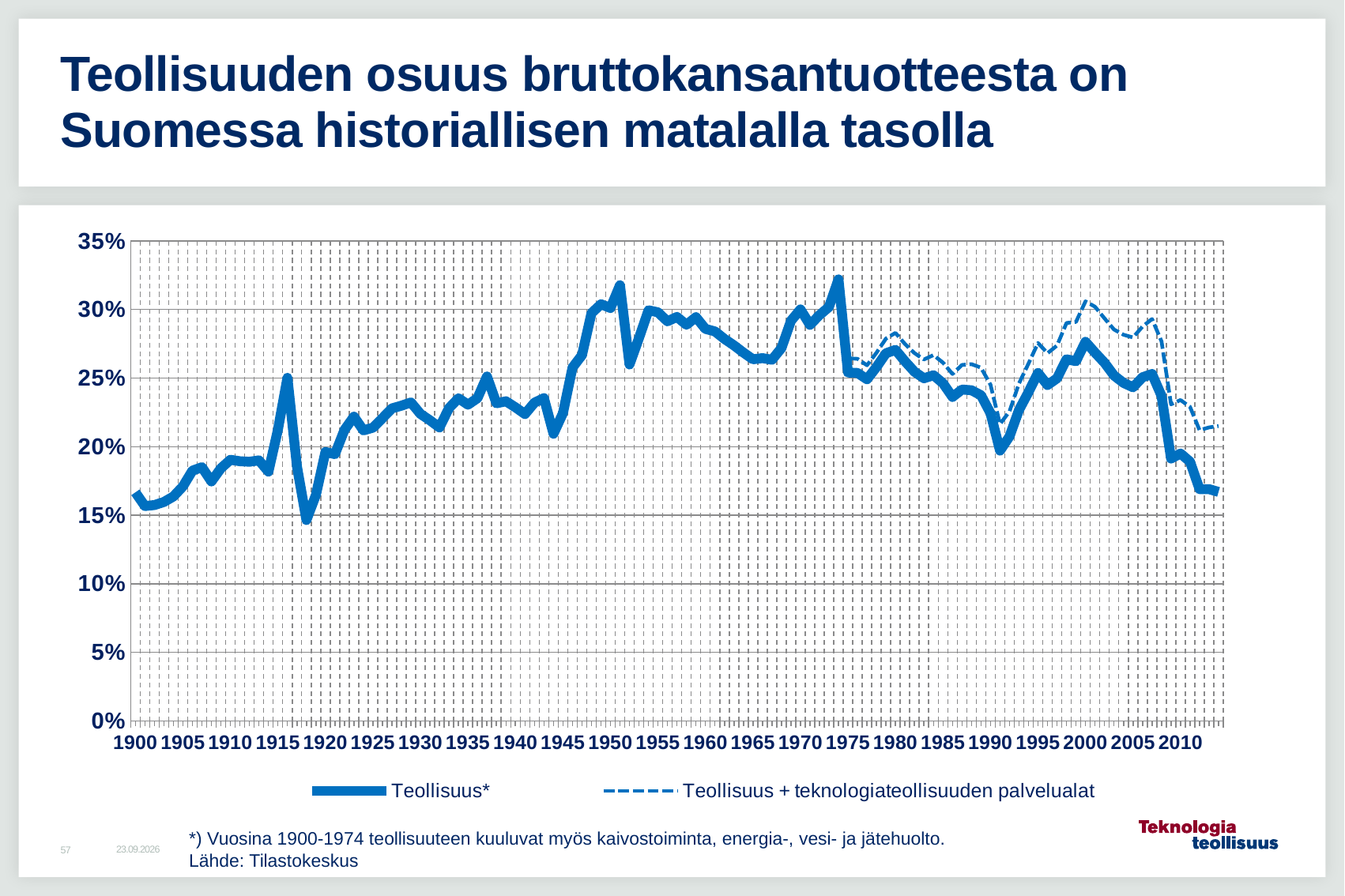
How many series does the legend list? 2 Which is larger for Teollisuus*: the value in 1950 or the value in 1900? 1950 Is the value for Teollisuus* at the last year shown (around 2013) greater or less than 20%? less Is the value for Teollisuus* in 1974 greater or less than 30%? greater What kind of chart is shown on the slide? line chart In 2000, which series has the higher value: Teollisuus* or Teollisuus + teknologiateollisuuden palvelualat? Teollisuus + teknologiateollisuuden palvelualat Does the Teollisuus* series rise or fall between 2000 and the end of the chart? fall Is the value for Teollisuus + teknologiateollisuuden palvelualat at the last year shown (around 2013) greater or less than 20%? greater Which series is drawn with a dashed line? Teollisuus + teknologiateollisuuden palvelualat What is the source cited below the chart? Tilastokeskus